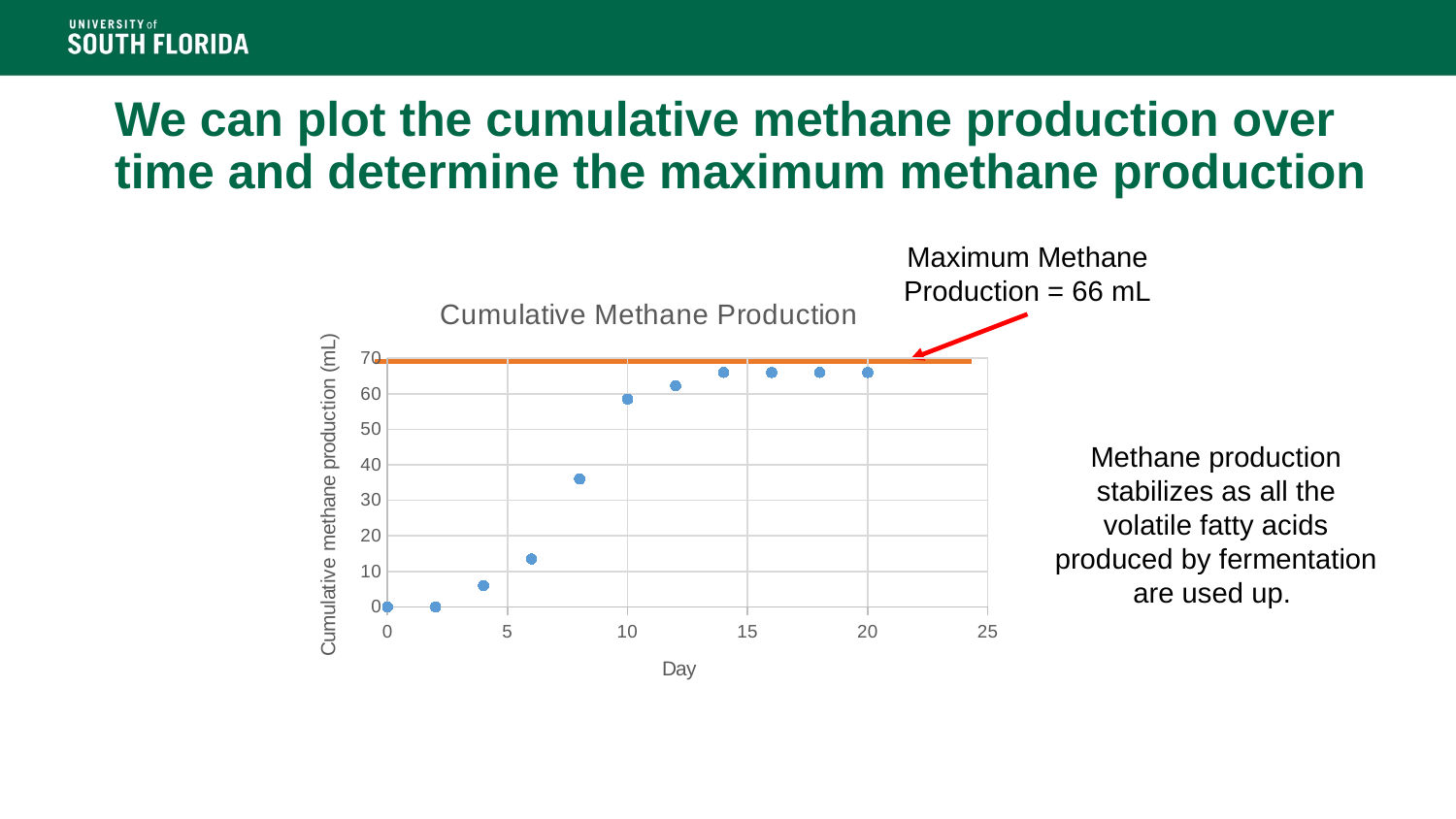
What is the title of the chart? Cumulative Methane Production What kind of chart is shown on the slide? scatter chart What is the label of the x axis of the chart? Day Do the cumulative methane production values rise or fall as the day increases? rise Is the cumulative methane production at day 10 greater or less than 50? greater Is the cumulative methane production at day 20 greater or less than 60? greater Is the cumulative methane production at day 8 greater or less than 40? less How many data points are plotted in the chart? 11 Which has the larger cumulative methane production, day 8 or day 4? day 8 Which has the larger cumulative methane production, day 10 or day 6? day 10